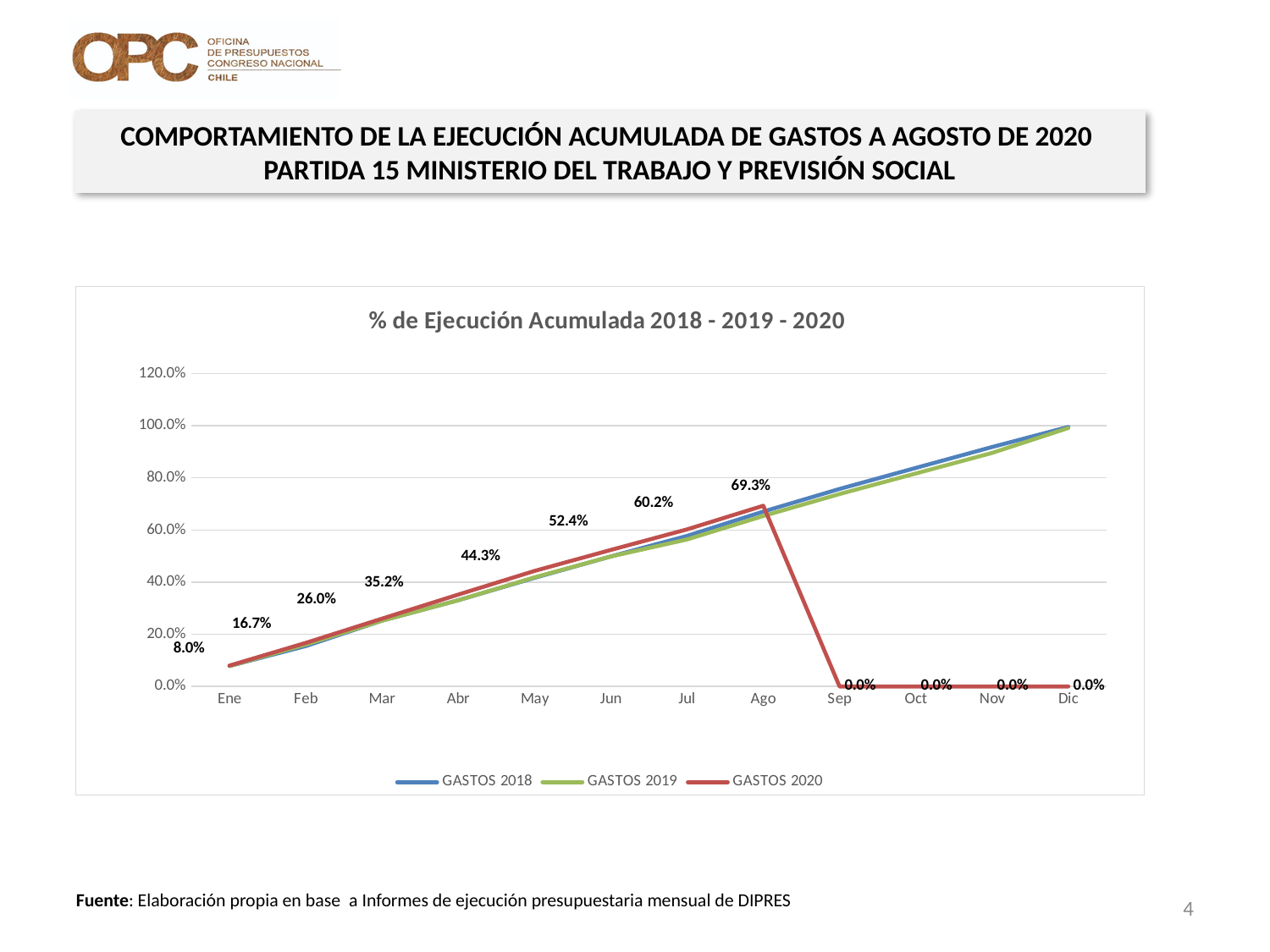
Which month has the highest GASTOS 2020 value? Ago What is the value for GASTOS 2020 in May? 44.3% What is the value for GASTOS 2020 in Sep? 0.0% What is the value for GASTOS 2020 in Ago? 69.3% How many series does the legend list? 3 What is the title of the chart? % de Ejecución Acumulada 2018 - 2019 - 2020 Does the GASTOS 2020 line rise or fall from Ene to Ago? rise How many months are shown on the x axis? 12 What is the difference between the GASTOS 2020 values for Ago and Jul? 9.1% What type of chart is shown on the slide? line chart Is the GASTOS 2020 value for Jun greater or less than 40.0%? greater What is the value for GASTOS 2020 in Ene? 8.0%